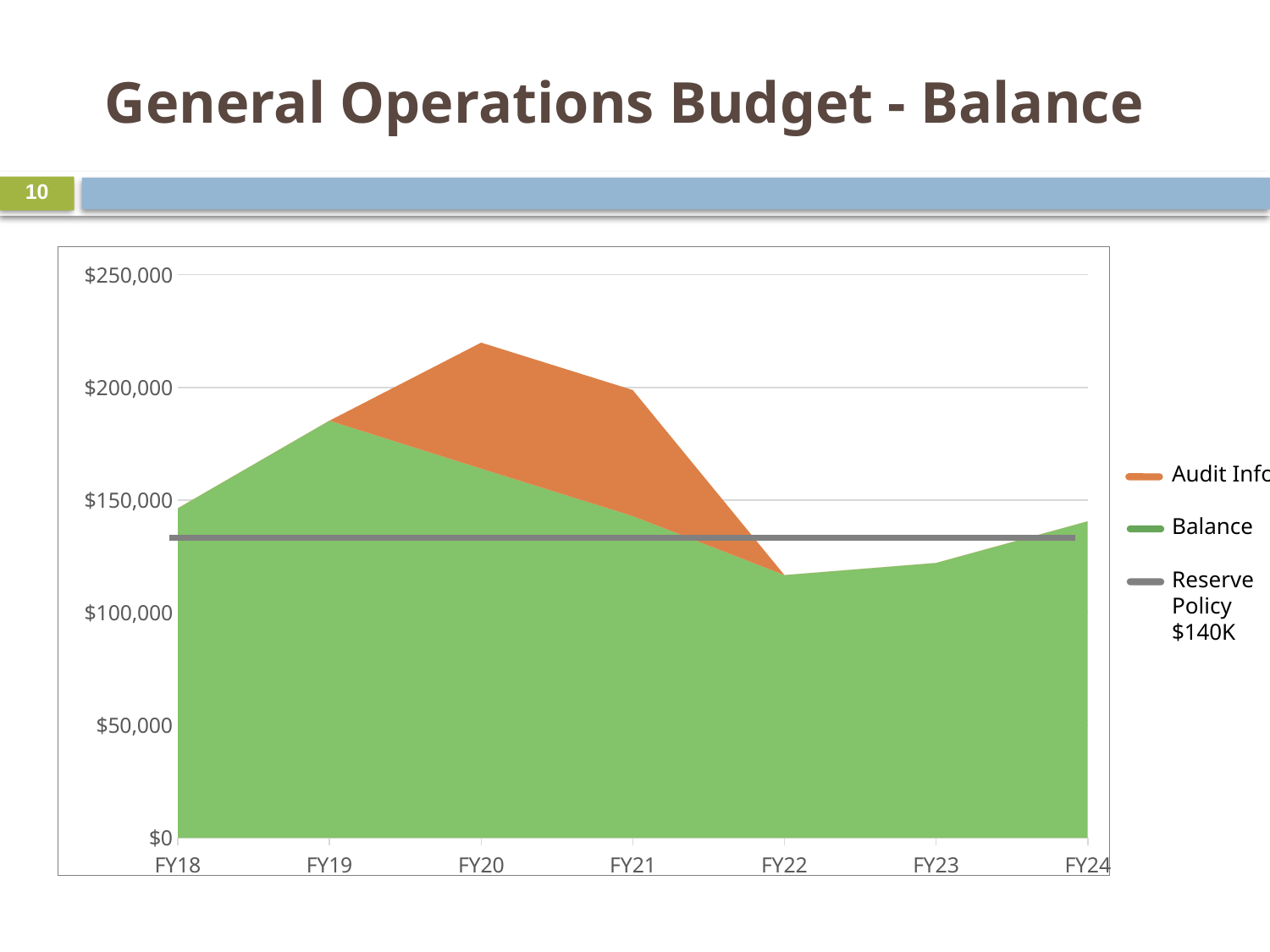
How many series does the chart's legend list? 3 What kind of chart is shown on the slide? Area chart Does the Balance series rise or fall from FY19 to FY22? Fall Which is larger, the Balance value for FY19 or the Balance value for FY22? FY19 What colour represents the Balance series in the chart? Green How many fiscal years are shown on the x axis of the chart? 7 Is the Balance value for FY22 greater or less than $150,000? less In which fiscal year is the Balance series highest? FY19 Is the Balance value for FY18 greater or less than $100,000? greater Is the Balance value for FY19 greater or less than $150,000? greater